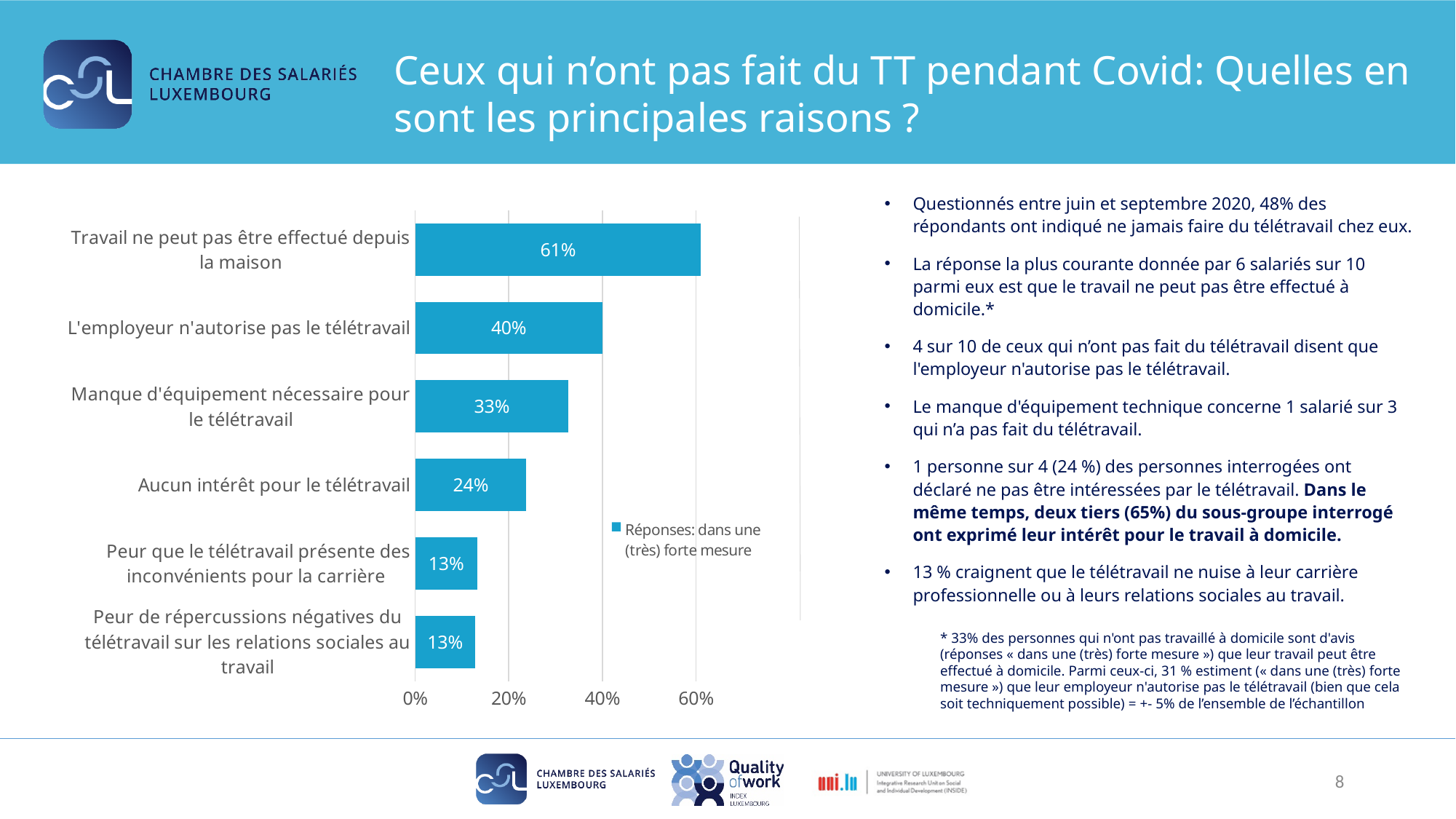
How many categories are shown in the chart? 6 Which category has the highest value? Travail ne peut pas être effectué depuis la maison What is the value for "Aucun intérêt pour le télétravail"? 24% What kind of chart is shown on the slide? Bar chart What is the value for "Manque d'équipement nécessaire pour le télétravail"? 33% What is the legend entry of the chart? Réponses: dans une (très) forte mesure Is the value for "L'employeur n'autorise pas le télétravail" greater or less than 20%? greater What is the value for "L'employeur n'autorise pas le télétravail"? 40% What is the value for "Travail ne peut pas être effectué depuis la maison"? 61% Which is larger: the value for "Manque d'équipement nécessaire pour le télétravail" or the value for "Aucun intérêt pour le télétravail"? Manque d'équipement nécessaire pour le télétravail How many series does the legend list? 1 What is the difference between the values for "Travail ne peut pas être effectué depuis la maison" and "L'employeur n'autorise pas le télétravail"? 21%